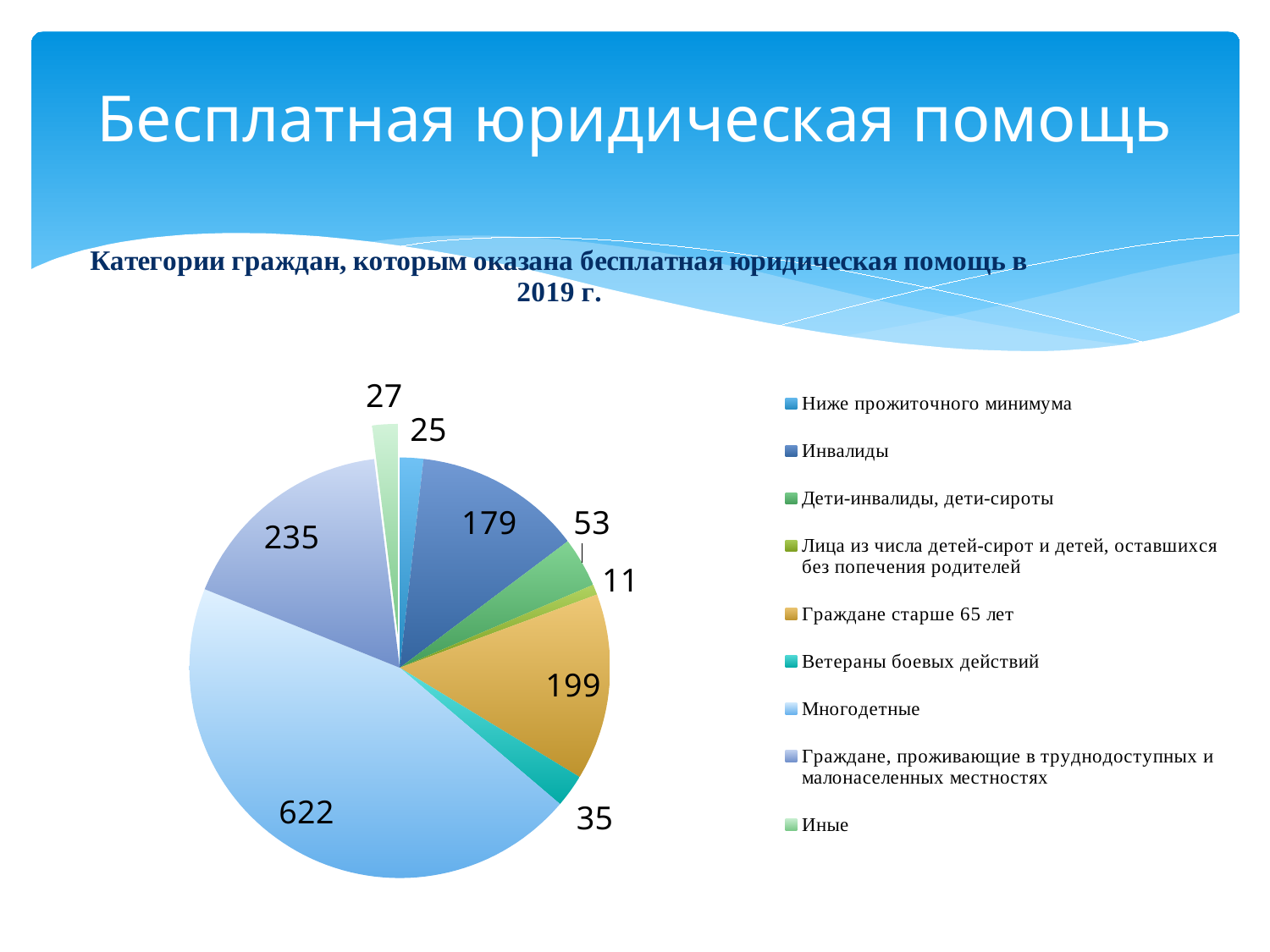
What is the value for Граждане старше 65 лет? 199 Which category has the smallest slice of the pie? Лица из числа детей-сирот и детей, оставшихся без попечения родителей What is the value for Инвалиды? 179 What is the total of all the values shown in the pie chart? 1386 Which is larger: the value for Инвалиды or the value for Граждане старше 65 лет? Граждане старше 65 лет What kind of chart is shown on the slide? pie chart How many categories does the pie chart have? 9 What is the title of the chart? Категории граждан, которым оказана бесплатная юридическая помощь в 2019 г. What is the value for Ветераны боевых действий? 35 Which category has the largest slice of the pie? Многодетные What is the difference between the values for Многодетные and Граждане, проживающие в труднодоступных и малонаселенных местностях? 387 What is the value for Многодетные? 622